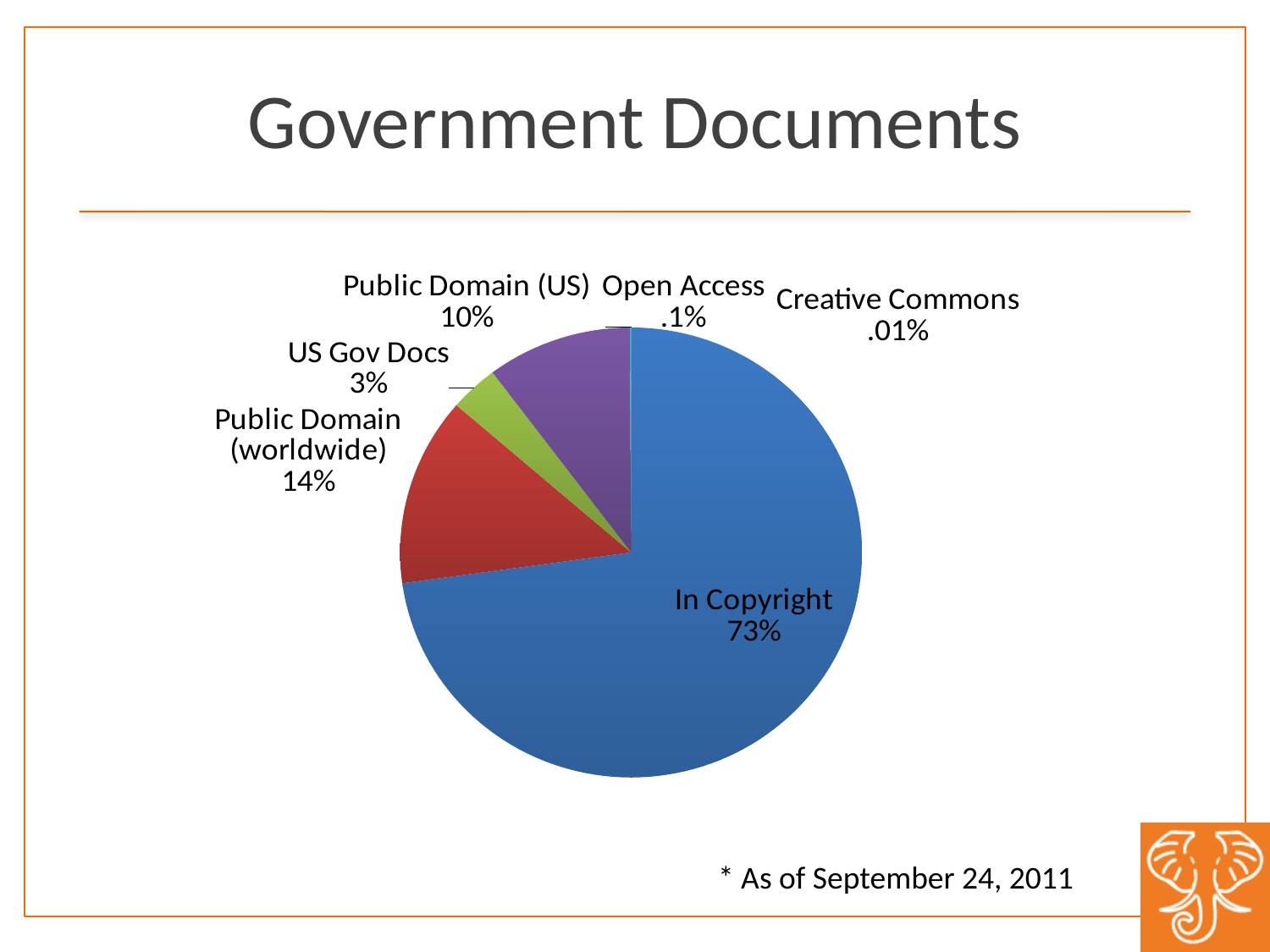
What is the difference in percentage points between Public Domain (worldwide) and Public Domain (US)? 4% Which is larger, the share for US Gov Docs or the share for Public Domain (US)? Public Domain (US) What percentage is shown for Public Domain (worldwide)? 14% What type of chart is shown on the slide? pie chart What percentage is shown for Public Domain (US)? 10% What share of the pie does In Copyright represent? 73% How many categories are shown in the pie chart? 6 Which category has the largest share of the pie? In Copyright What percentage is shown for US Gov Docs? 3% What percentage is shown for Open Access? .1% Which category has the smallest share of the pie? Creative Commons What percentage is shown for Creative Commons? .01%